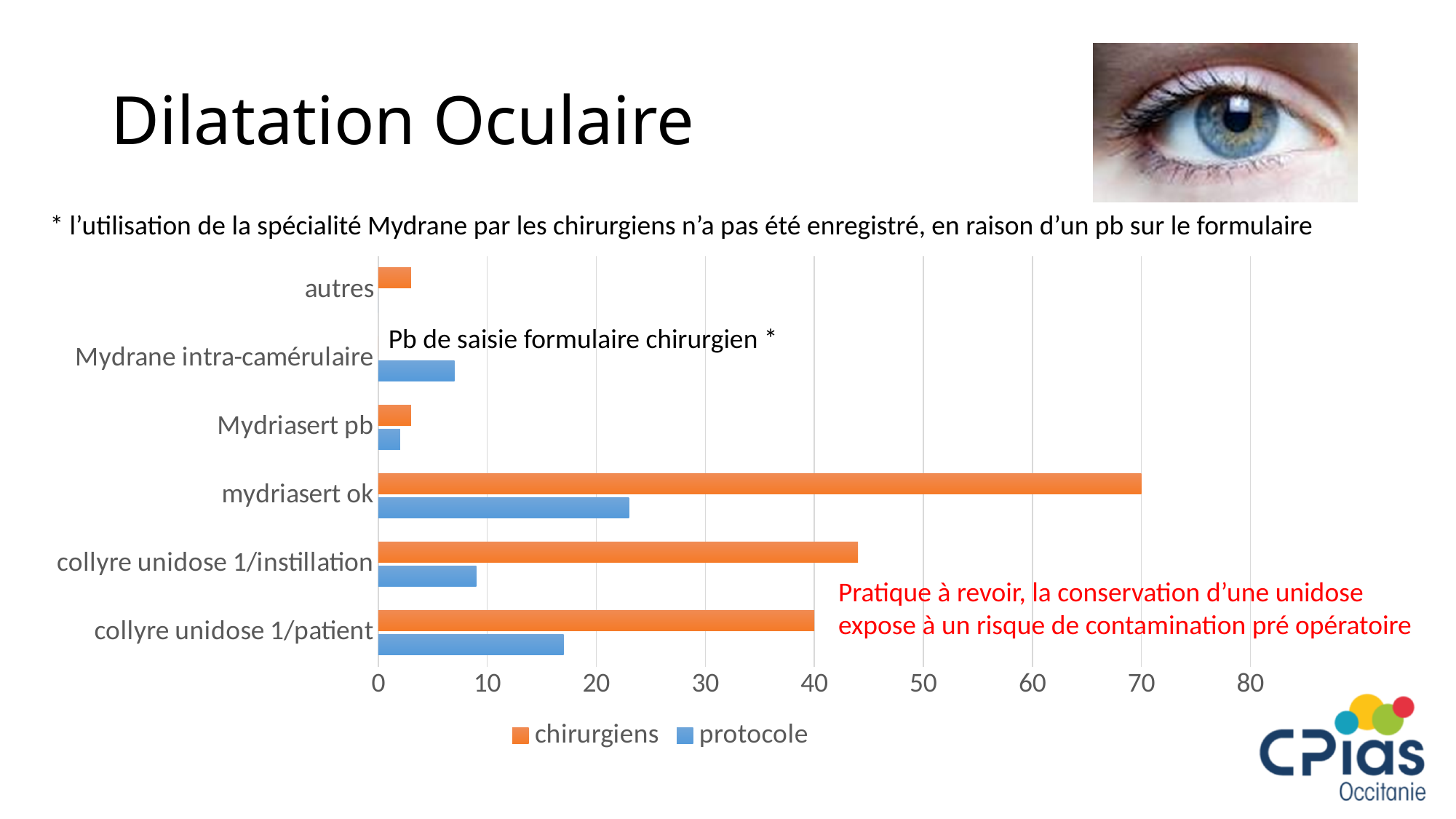
Is the chirurgiens value for collyre unidose 1/instillation greater or less than 40? greater How many categories are shown on the chart's vertical axis? 6 What is the chirurgiens value for mydriasert ok? 70 Is the protocole value for collyre unidose 1/patient greater or less than 20? less Which category has the highest value for the protocole series? mydriasert ok Which category has the highest value for the chirurgiens series? mydriasert ok Is the protocole value for Mydrane intra-camérulaire greater or less than 10? less For mydriasert ok, which series has the larger value, chirurgiens or protocole? chirurgiens What kind of chart is shown on the slide? bar chart How many series does the chart legend list? 2 What is the chirurgiens value for collyre unidose 1/patient? 40 Which colour represents the protocole series in the chart? blue